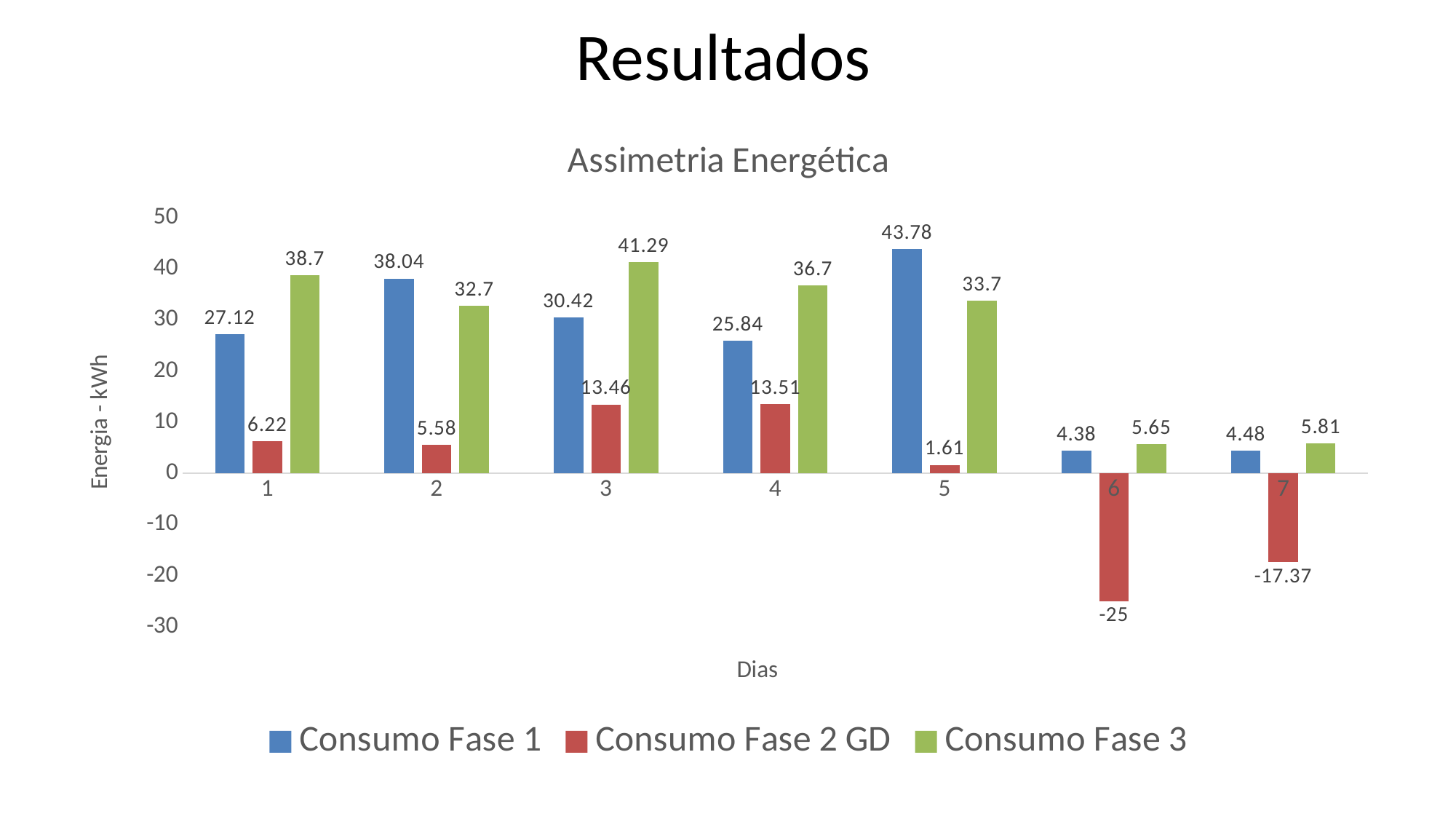
What is the label of the y axis? Energia - kWh On which day is Consumo Fase 2 GD lowest? 6 What kind of chart is shown? Bar chart On which day is Consumo Fase 1 highest? 5 What is the value of Consumo Fase 3 on day 3? 41.29 What is the value of Consumo Fase 1 on day 5? 43.78 What is the title of the chart? Assimetria Energética What is the difference between Consumo Fase 3 and Consumo Fase 1 on day 1? 11.58 How many days are shown on the x axis? 7 How many series does the legend list? 3 What is the value of Consumo Fase 2 GD on day 6? -25 Which is larger on day 2: Consumo Fase 1 or Consumo Fase 3? Consumo Fase 1